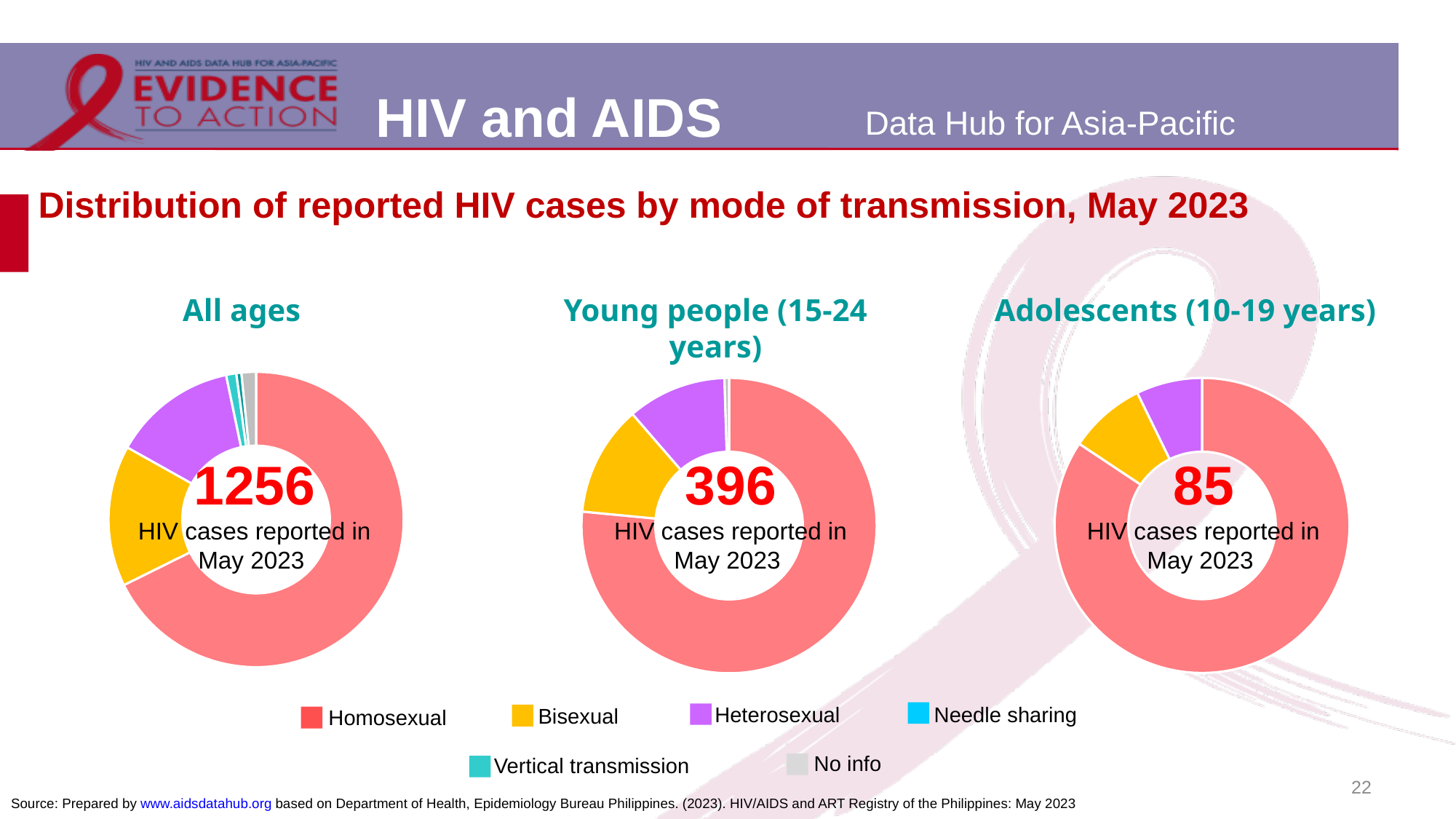
On the Young people (15-24 years) chart, how many HIV cases were reported in May 2023? 396 What kind of chart is used to show the distribution of HIV cases on this slide? Pie (donut) chart On the Young people (15-24 years) chart, which mode of transmission has the largest slice? Homosexual On the All ages chart, which mode of transmission accounts for the largest share of cases? Homosexual On the All ages chart, which slice is larger: Bisexual or Heterosexual? Bisexual How many more HIV cases were reported for All ages than for Young people (15-24 years) in May 2023? 860 How many more HIV cases were reported for Young people (15-24 years) than for Adolescents (10-19 years) in May 2023? 311 What colour represents Heterosexual transmission in the legend? Purple On the All ages chart, how many HIV cases were reported in May 2023? 1256 On the Adolescents (10-19 years) chart, which mode of transmission has the largest slice? Homosexual How many modes of transmission does the legend list? 6 On the Adolescents (10-19 years) chart, how many HIV cases were reported in May 2023? 85